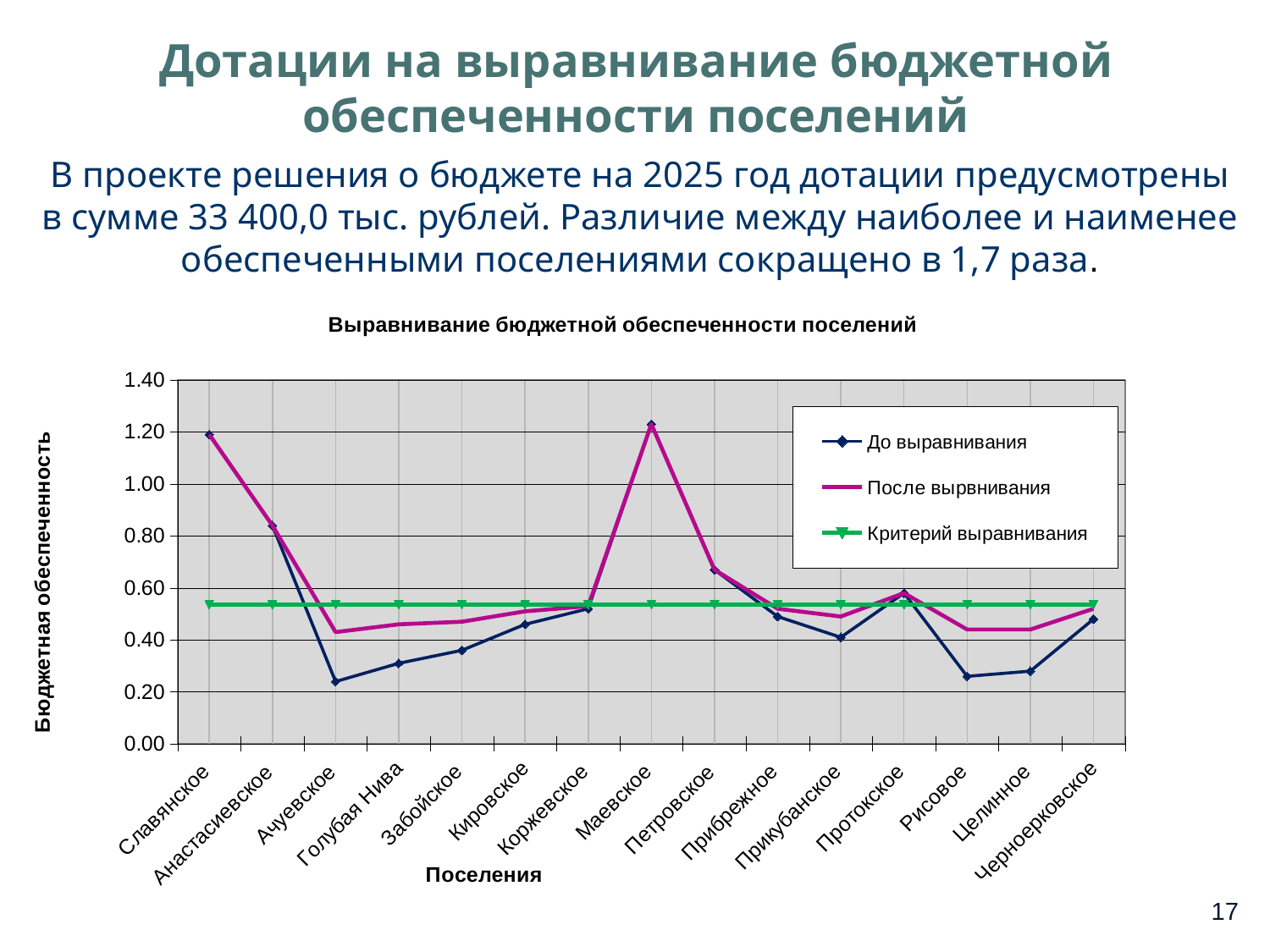
Is the value for Маевское in the series После вырвнивания greater or less than 1.00? greater Is the value for Рисовое in the series До выравнивания greater or less than 0.40? less Is the value for Славянское in the series До выравнивания greater or less than 1.00? greater In the series До выравнивания, which is larger: the value for Славянское or the value for Ачуевское? Славянское How many series does the legend list? 3 What is the title of the chart? Выравнивание бюджетной обеспеченности поселений What kind of chart is shown on the slide? line chart In the series До выравнивания, which is larger: the value for Маевское or the value for Петровское? Маевское How many settlements (categories) are plotted along the x axis? 15 Does the До выравнивания line rise or fall from Славянское to Ачуевское? fall